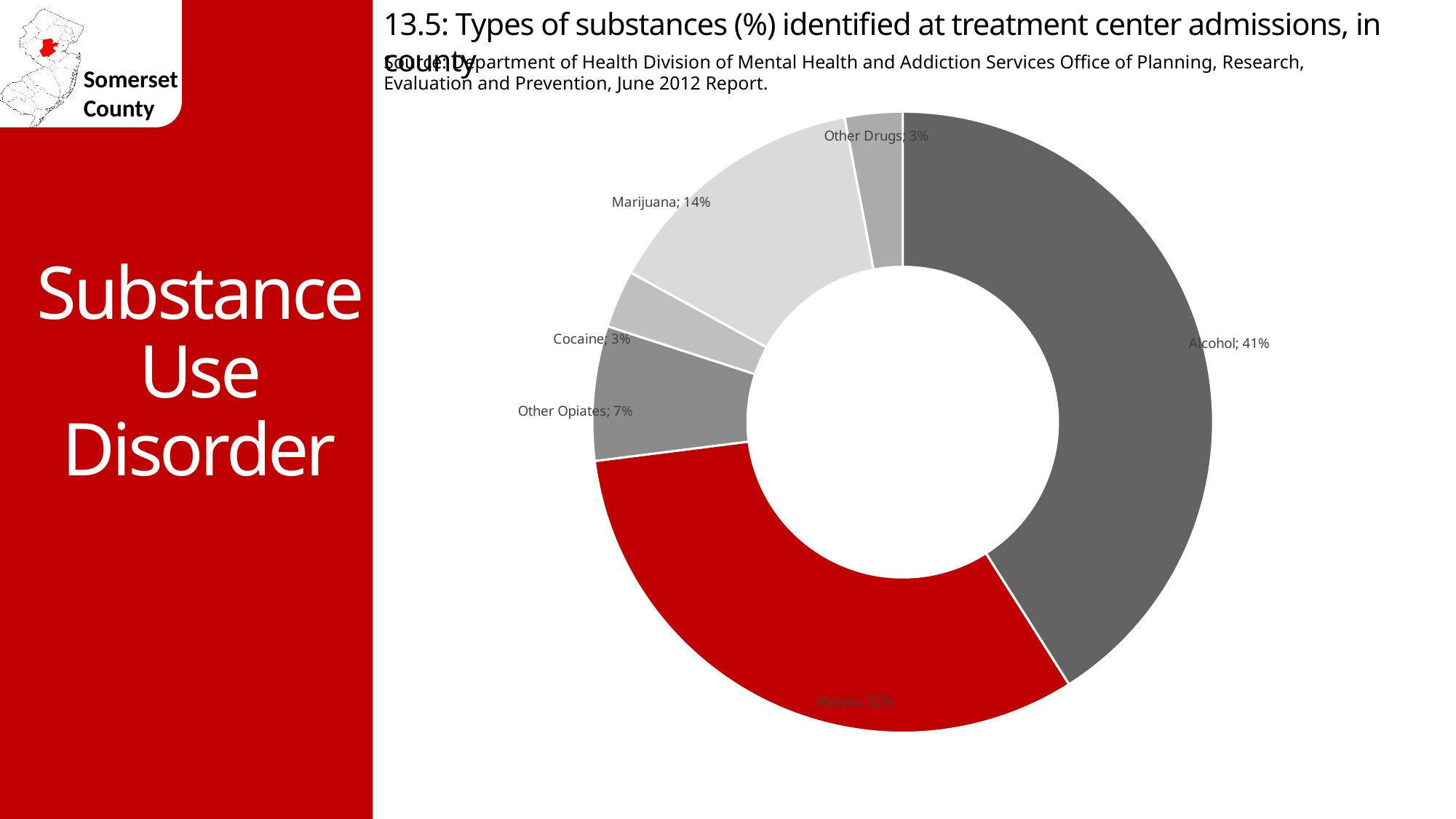
What percentage is shown for Other Opiates? 7% What percentage is shown for Marijuana? 14% What is the difference in percentage points between Marijuana and Other Opiates? 7 What is the difference in percentage points between Alcohol and Heroin? 9 Which substance has the larger share, Heroin or Marijuana? Heroin What percentage is shown for Heroin? 32% Which slice of the chart is coloured red? Heroin What percentage is shown for Alcohol? 41% What kind of chart is used on this slide? Doughnut (pie) chart Which substance has the largest share of treatment center admissions? Alcohol How many substance categories are shown in the chart? 6 Which two categories share the same percentage of 3%? Cocaine and Other Drugs